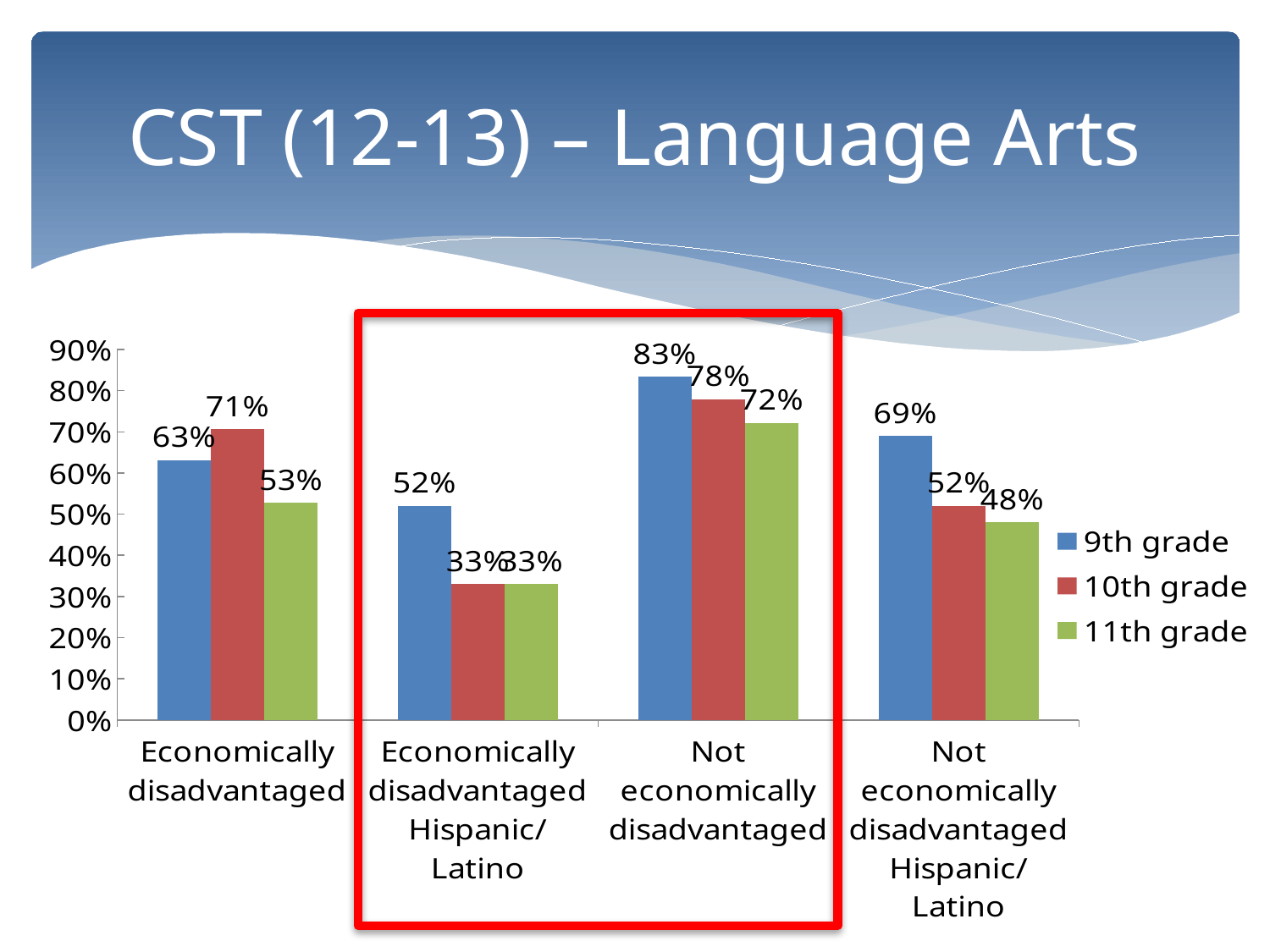
Which category has the highest 9th grade value? Not economically disadvantaged Which category has the lowest 10th grade value? Economically disadvantaged Hispanic/Latino Is the 9th grade value for Not economically disadvantaged Hispanic/Latino greater or less than 60%? greater Which is larger: the 10th grade value for Economically disadvantaged or the 10th grade value for Not economically disadvantaged? Not economically disadvantaged How many categories are shown on the x axis? 4 What is the title of the slide? CST (12-13) – Language Arts What is the 11th grade value for Not economically disadvantaged? 72% What kind of chart is shown on the slide? bar chart What is the 9th grade value for Economically disadvantaged? 63% How many series does the legend list? 3 What is the difference between the 9th grade and 11th grade values for Economically disadvantaged Hispanic/Latino? 19% What is the 10th grade value for Not economically disadvantaged Hispanic/Latino? 52%